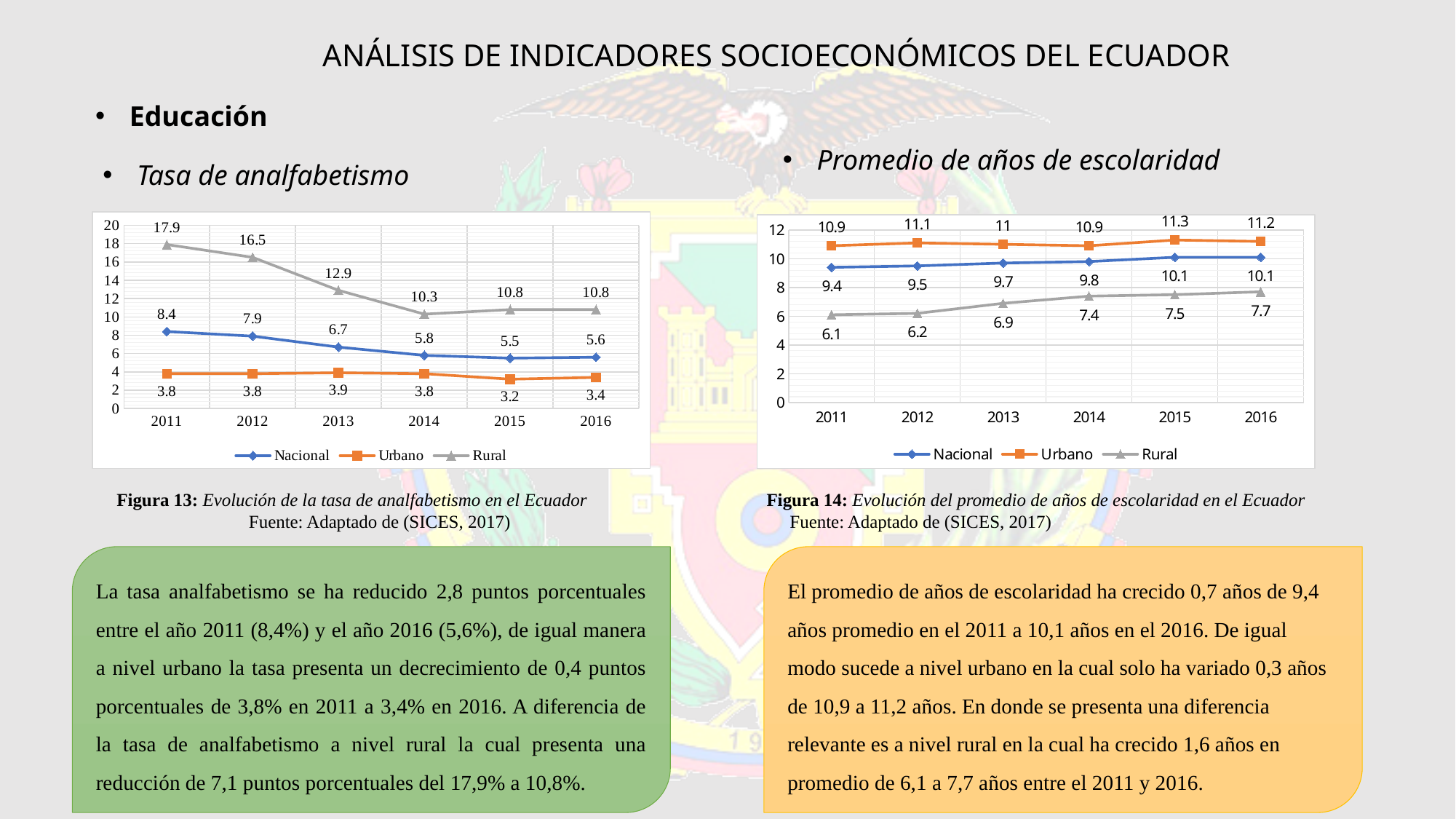
What type of chart is the right chart (Promedio de años de escolaridad)? line chart In the left chart (Tasa de analfabetismo), which year has the lowest Urbano value? 2015 In the right chart (Promedio de años de escolaridad), how many years are shown on the x axis? 6 In the right chart (Promedio de años de escolaridad), what is the Urbano value for 2015? 11.3 In the left chart (Tasa de analfabetismo), how many series does the legend list? 3 In the left chart (Tasa de analfabetismo), what is the Nacional value for 2016? 5.6 In the right chart (Promedio de años de escolaridad), which year has the highest Rural value? 2016 In the left chart (Tasa de analfabetismo), does the Rural series generally rise or fall from 2011 to 2016? fall In the left chart (Tasa de analfabetismo), what is the Rural value for 2011? 17.9 In the right chart (Promedio de años de escolaridad), which is larger in 2014: the Nacional value or the Rural value? Nacional In the right chart (Promedio de años de escolaridad), what is the Rural value for 2013? 6.9 In the left chart (Tasa de analfabetismo), what is the difference between the Rural values for 2011 and 2016? 7.1